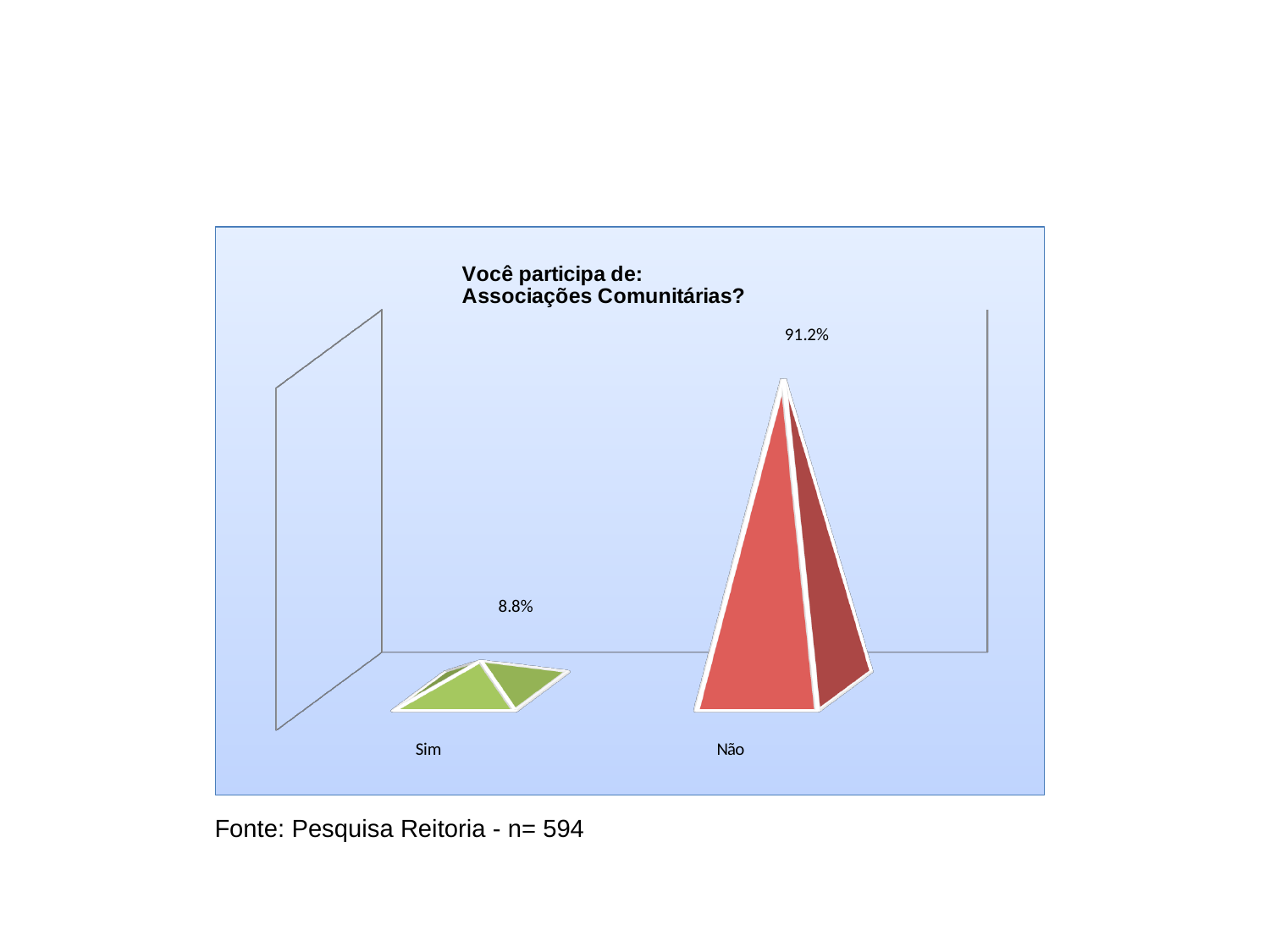
Which is larger, the value for Sim or the value for Não? Não What is the value for Sim? 8.8% What kind of chart is shown on the slide? bar chart What is the difference between the values for Não and Sim? 82.4% Which category has the highest value? Não Which category has the lowest value? Sim What is the total of the values for Sim and Não? 100% What is the title of the chart? Você participa de: Associações Comunitárias? What is the value for Não? 91.2% What colour is the bar for Não? red How many categories are shown in the chart? 2